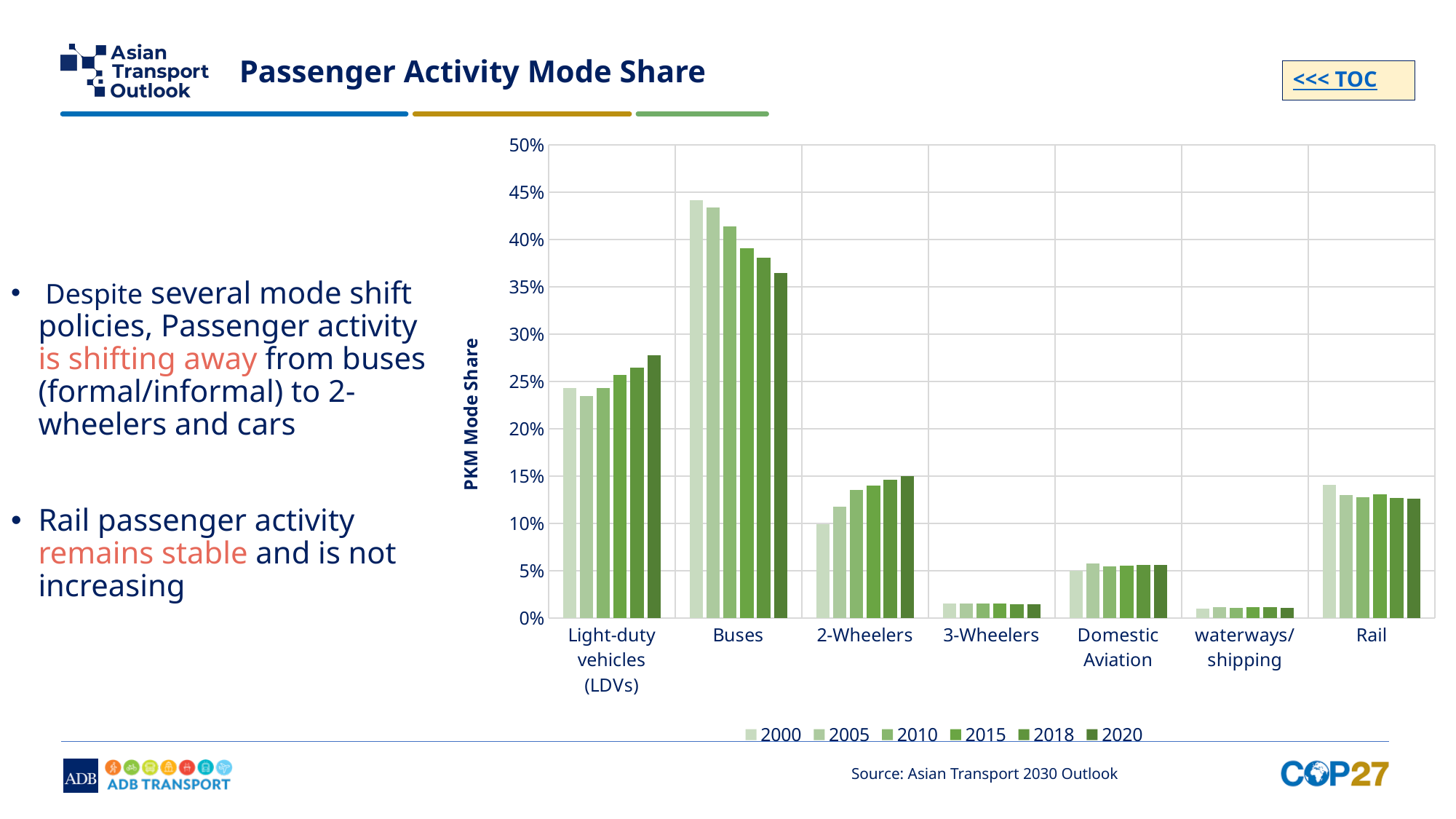
What is the label on the vertical axis of the chart? PKM Mode Share How many series (years) does the chart legend list? 6 Which category has the highest PKM mode share in 2000? Buses Is the 2020 value for Buses greater or less than 40%? less Is the 2000 value for Buses greater or less than 40%? greater Which is larger in 2020, the value for Rail or the value for 2-Wheelers? 2-Wheelers What kind of chart is shown on the slide? Bar chart Is the 2000 value for 2-Wheelers greater or less than 15%? less How many transport mode categories are shown on the x axis of the chart? 7 Does the PKM mode share for Buses rise or fall from 2000 to 2020? Fall Which category has the lowest PKM mode share in 2020? waterways/shipping